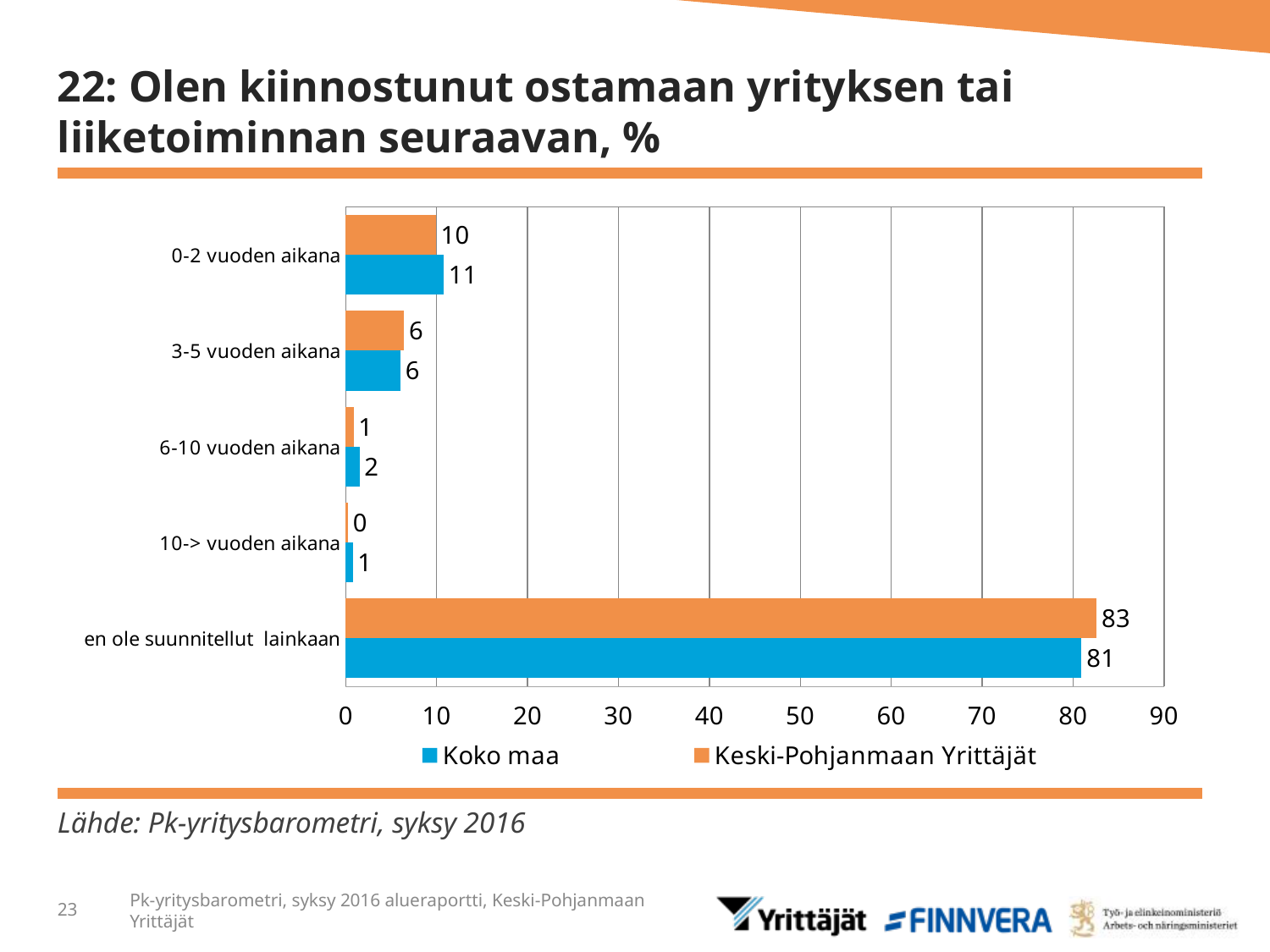
Is the Koko maa value for 'en ole suunnitellut lainkaan' greater or less than 70? greater Which colour represents the Koko maa series? blue What kind of chart is shown on the slide? bar chart Which category has the highest value for Koko maa? en ole suunnitellut lainkaan How many categories are shown on the chart? 5 Which category has the lowest value for Keski-Pohjanmaan Yrittäjät? 10-> vuoden aikana How many series does the legend list? 2 What is the difference between the Keski-Pohjanmaan Yrittäjät and Koko maa values in the 'en ole suunnitellut lainkaan' category? 2 What is the value for Keski-Pohjanmaan Yrittäjät in the '6-10 vuoden aikana' category? 1 In the '0-2 vuoden aikana' category, which series has the larger value, Koko maa or Keski-Pohjanmaan Yrittäjät? Koko maa What is the value for Keski-Pohjanmaan Yrittäjät in the 'en ole suunnitellut lainkaan' category? 83 What is the value for Koko maa in the '0-2 vuoden aikana' category? 11